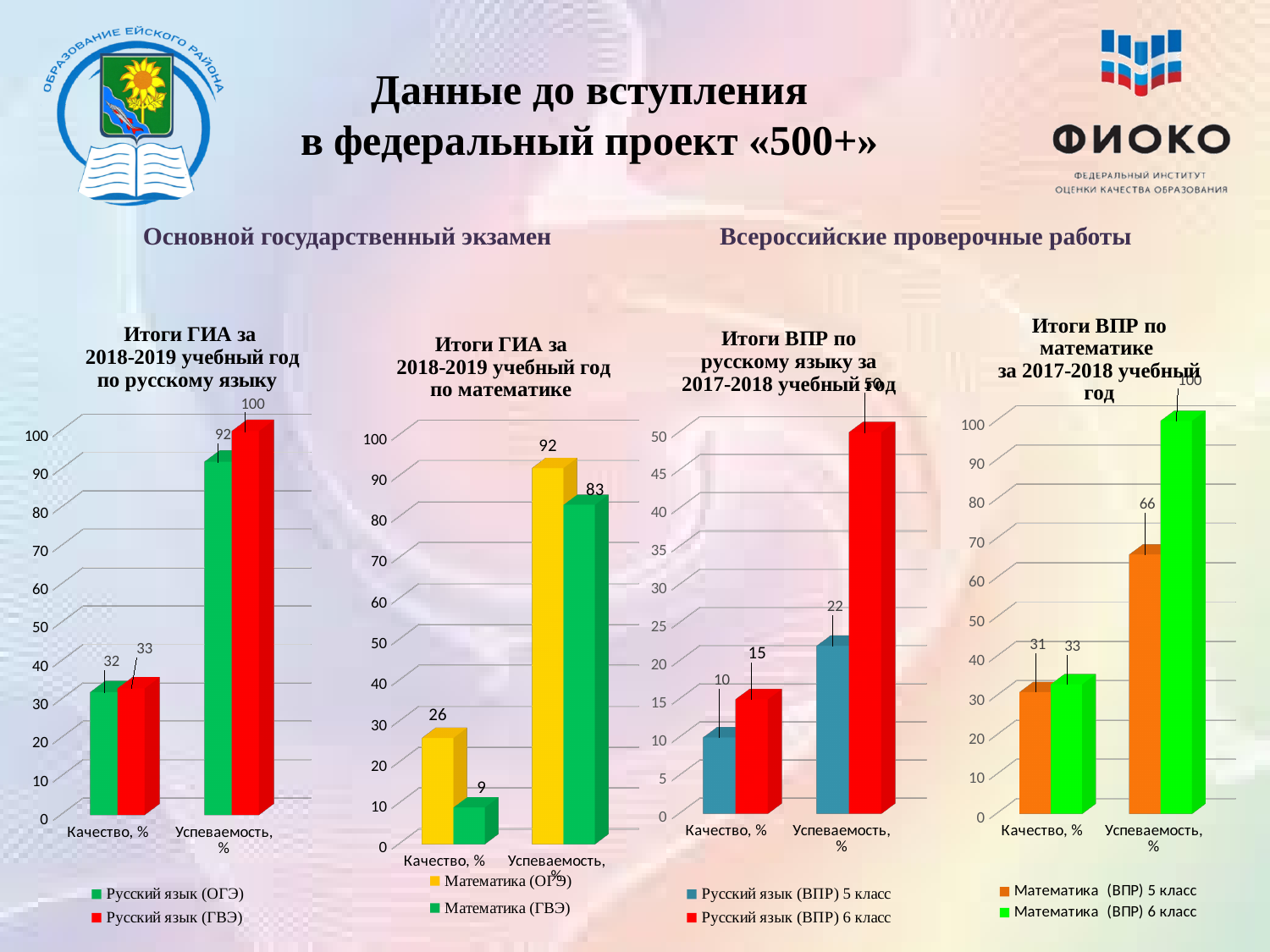
In the chart 'Итоги ВПР по русскому языку за 2017-2018 учебный год', is the value of Успеваемость, % for Русский язык (ВПР) 6 класс greater or less than 45? greater In the chart 'Итоги ГИА за 2018-2019 учебный год по математике', what is the value of Качество, % for Математика (ГВЭ)? 9 In the chart 'Итоги ВПР по математике за 2017-2018 учебный год', what is the value of Успеваемость, % for Математика (ВПР) 5 класс? 66 In the chart 'Итоги ГИА за 2018-2019 учебный год по математике', which series has the higher Успеваемость, %: Математика (ОГЭ) or Математика (ГВЭ)? Математика (ОГЭ) What type of chart is 'Итоги ВПР по математике за 2017-2018 учебный год'? Bar chart In the chart 'Итоги ГИА за 2018-2019 учебный год по русскому языку', what is the difference between Успеваемость, % for Русский язык (ГВЭ) and Русский язык (ОГЭ)? 8 In the chart 'Итоги ВПР по русскому языку за 2017-2018 учебный год', what is the value of Успеваемость, % for Русский язык (ВПР) 5 класс? 22 In the chart 'Итоги ВПР по русскому языку за 2017-2018 учебный год', what is the value of Качество, % for Русский язык (ВПР) 6 класс? 15 In the chart 'Итоги ВПР по математике за 2017-2018 учебный год', how many series does the legend list? 2 In the chart 'Итоги ГИА за 2018-2019 учебный год по русскому языку', what is the value of Успеваемость, % for Русский язык (ГВЭ)? 100 In the chart 'Итоги ГИА за 2018-2019 учебный год по математике', what is the difference between Качество, % for Математика (ОГЭ) and Математика (ГВЭ)? 17 In the chart 'Итоги ГИА за 2018-2019 учебный год по русскому языку', what is the value of Качество, % for Русский язык (ОГЭ)? 32